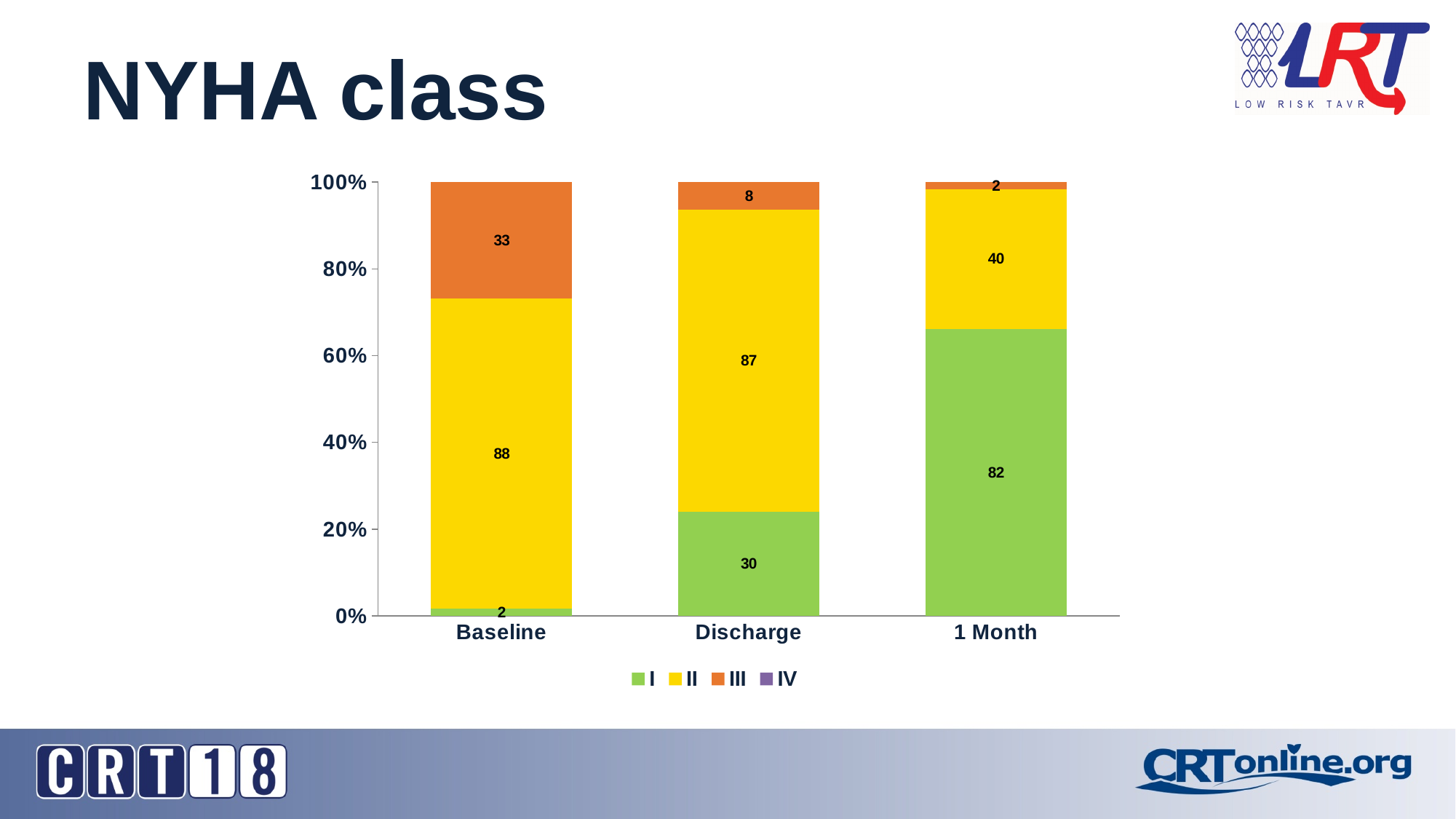
What is the difference between the class III values at Baseline and Discharge? 25 What is the data label for class I at Discharge? 30 How many series does the legend list? 4 Does the class I value rise or fall from Baseline to 1 Month? rise What is the data label for class III at 1 Month? 2 What is the data label for class II at Baseline? 88 Which is larger: the class II value at Discharge or the class II value at 1 Month? Discharge At which time point is the class I value highest? 1 Month What type of chart is shown on the slide? stacked bar chart How many time points are shown on the x axis? 3 What is the data label for class I at 1 Month? 82 At which time point is the class III value lowest? 1 Month